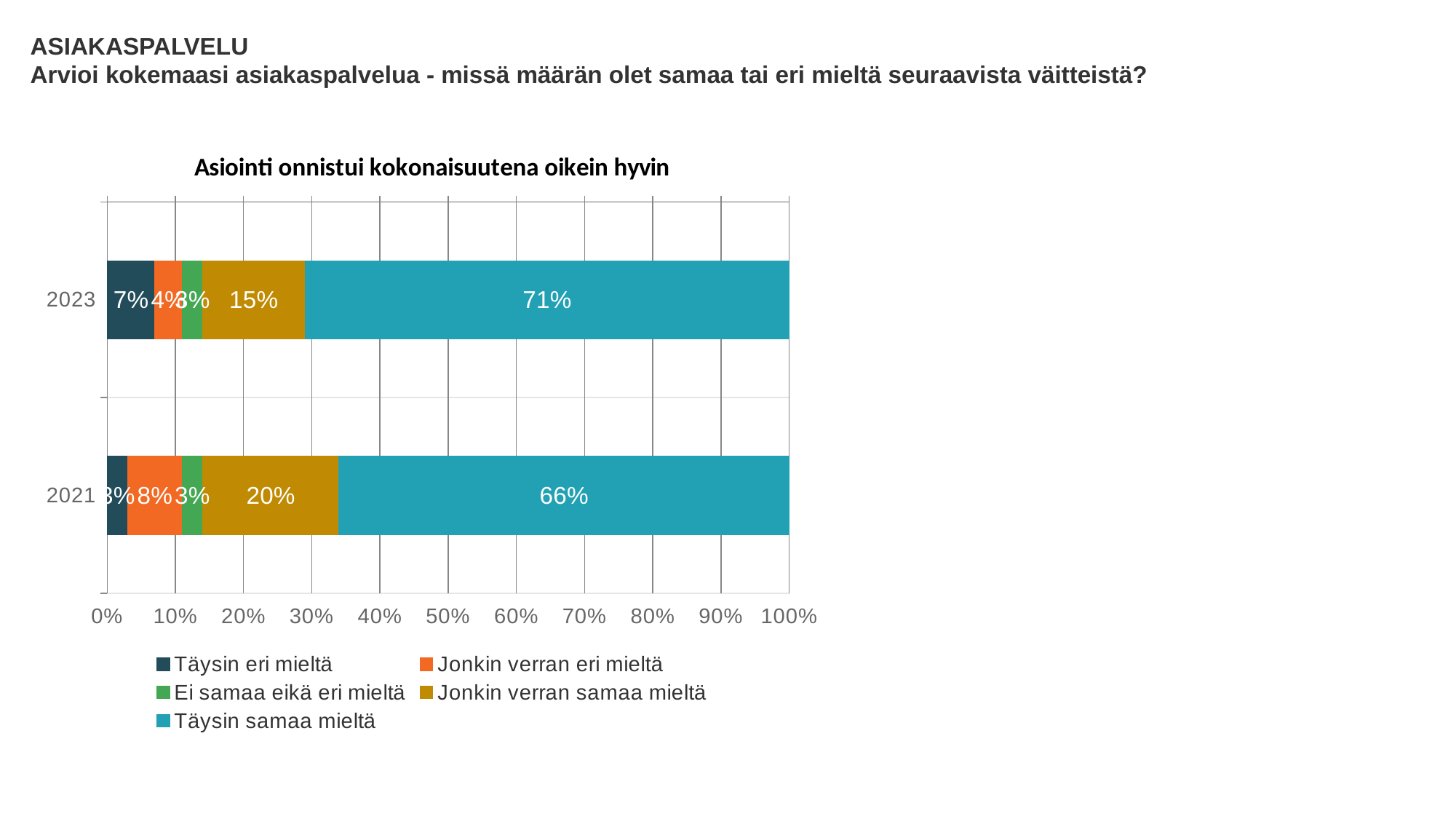
What is the value for "Jonkin verran samaa mieltä" in 2023? 15% What is the value for "Täysin eri mieltä" in 2023? 7% Which response category has the largest share in the 2023 bar? Täysin samaa mieltä What percentage of respondents in 2021 answered "Täysin samaa mieltä"? 66% How many series does the legend list? 5 What percentage of respondents in 2023 answered "Täysin samaa mieltä"? 71% What type of chart is shown on the slide? Stacked bar chart Which year has the larger share of "Jonkin verran samaa mieltä", 2021 or 2023? 2021 What is the value for "Jonkin verran eri mieltä" in 2021? 8% By how many percentage points did the share of "Täysin samaa mieltä" change from 2021 to 2023? 5 percentage points How many years (categories) are shown in the chart? 2 What is the value for "Jonkin verran samaa mieltä" in 2021? 20%